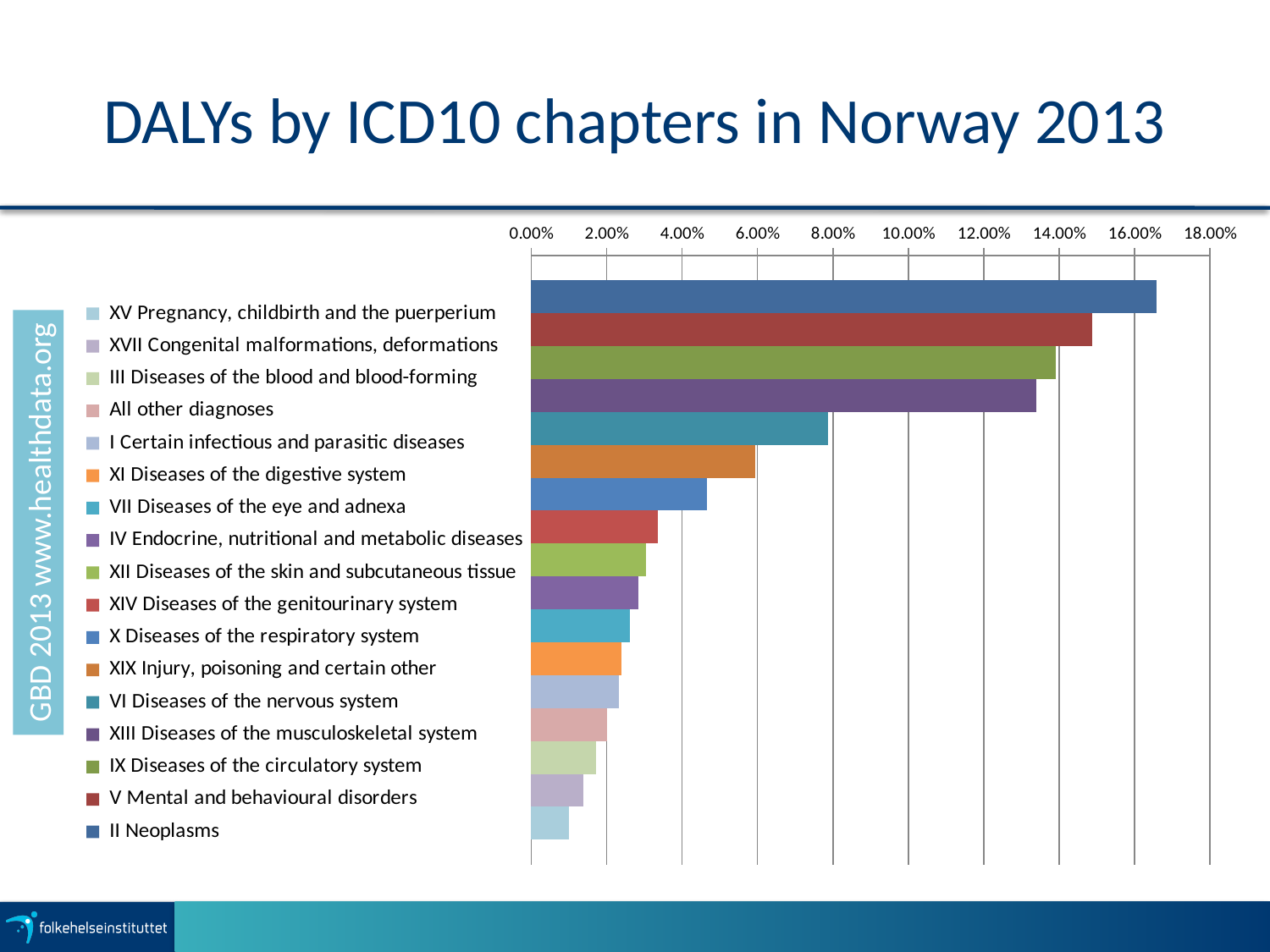
What is the title of the chart? DALYs by ICD10 chapters in Norway 2013 What kind of chart is shown on the slide? bar chart Is the value for II Neoplasms greater or less than 16.00%? greater Is the value for XIX Injury, poisoning and certain other greater or less than 4.00%? greater What is the highest value shown on the percentage axis? 18.00% Which ICD10 chapter has the highest share of DALYs? II Neoplasms Which is larger, the value for X Diseases of the respiratory system or the value for XIX Injury, poisoning and certain other? XIX Injury, poisoning and certain other Is the value for XV Pregnancy, childbirth and the puerperium greater or less than 2.00%? less How many series does the legend list? 17 Which is larger, the value for V Mental and behavioural disorders or the value for XIII Diseases of the musculoskeletal system? V Mental and behavioural disorders Which ICD10 chapter has the lowest share of DALYs? XV Pregnancy, childbirth and the puerperium